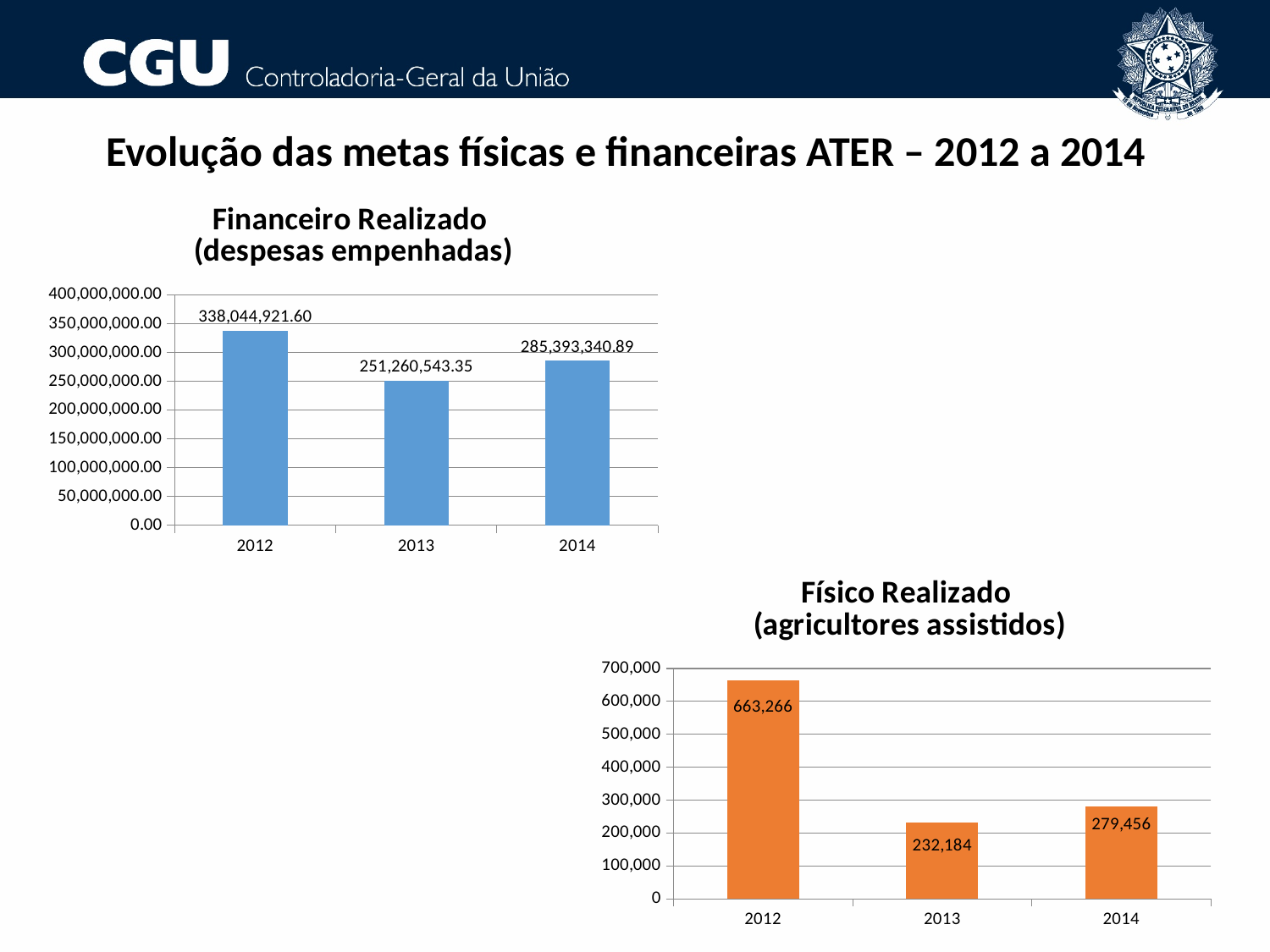
In the 'Financeiro Realizado (despesas empenhadas)' chart, is the value for 2014 greater or less than 300,000,000.00? less In the 'Físico Realizado (agricultores assistidos)' chart, which is larger, the value for 2013 or the value for 2014? 2014 In the 'Físico Realizado (agricultores assistidos)' chart, how many years are shown on the x axis? 3 What kind of chart is the 'Físico Realizado (agricultores assistidos)' chart? bar chart In the 'Financeiro Realizado (despesas empenhadas)' chart, what is the value for 2012? 338,044,921.60 In the 'Financeiro Realizado (despesas empenhadas)' chart, what is the value for 2013? 251,260,543.35 In the 'Financeiro Realizado (despesas empenhadas)' chart, which year has the lowest value? 2013 In the 'Financeiro Realizado (despesas empenhadas)' chart, what is the difference between the 2012 and 2013 values? 86,784,378.25 What colour are the bars in the 'Financeiro Realizado (despesas empenhadas)' chart? blue In the 'Físico Realizado (agricultores assistidos)' chart, which year has the highest value? 2012 In the 'Físico Realizado (agricultores assistidos)' chart, what is the difference between the 2012 and 2013 values? 431,082 In the 'Físico Realizado (agricultores assistidos)' chart, what is the value for 2014? 279,456